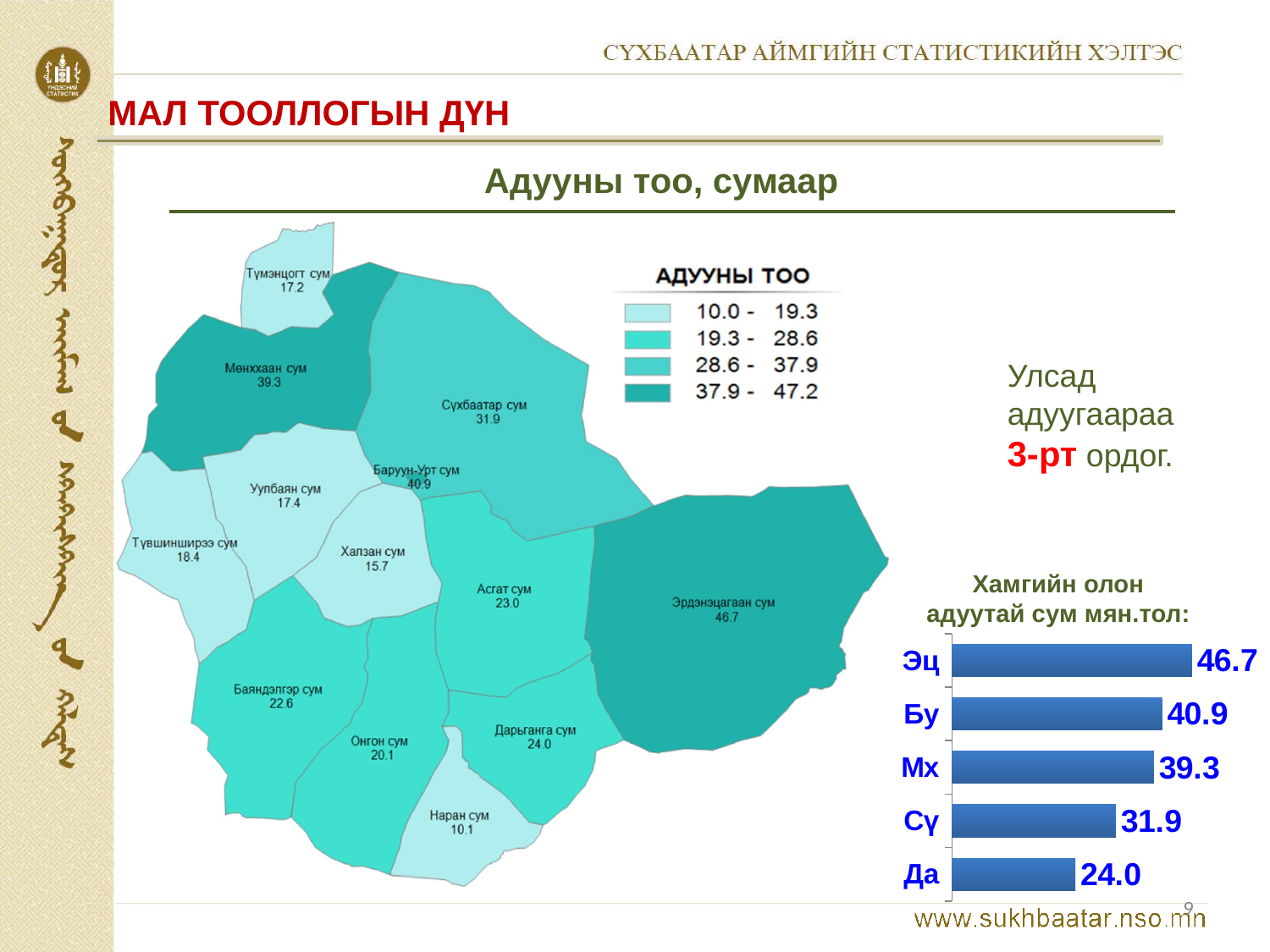
In the bar chart 'Хамгийн олон адуутай сум мян.тол:', what is the value for Бу? 40.9 In the bar chart 'Хамгийн олон адуутай сум мян.тол:', which is larger, the value for Мх or the value for Сү? Мх In the bar chart 'Хамгийн олон адуутай сум мян.тол:', what is the difference between the values for Эц and Да? 22.7 In the bar chart 'Хамгийн олон адуутай сум мян.тол:', what is the value for Сү? 31.9 On the map 'Адууны тоо', what is the value shown for Наран сум? 10.1 On the map 'Адууны тоо', what is the value shown for Эрдэнэцагаан сум? 46.7 In the bar chart 'Хамгийн олон адуутай сум мян.тол:', which category has the highest value? Эц In the bar chart 'Хамгийн олон адуутай сум мян.тол:', which category has the lowest value? Да In the bar chart 'Хамгийн олон адуутай сум мян.тол:', what is the value for Эц? 46.7 In the bar chart 'Хамгийн олон адуутай сум мян.тол:', what is the difference between the values for Бу and Мх? 1.6 What kind of chart is 'Хамгийн олон адуутай сум мян.тол:'? Bar chart How many categories are shown in the bar chart 'Хамгийн олон адуутай сум мян.тол:'? 5